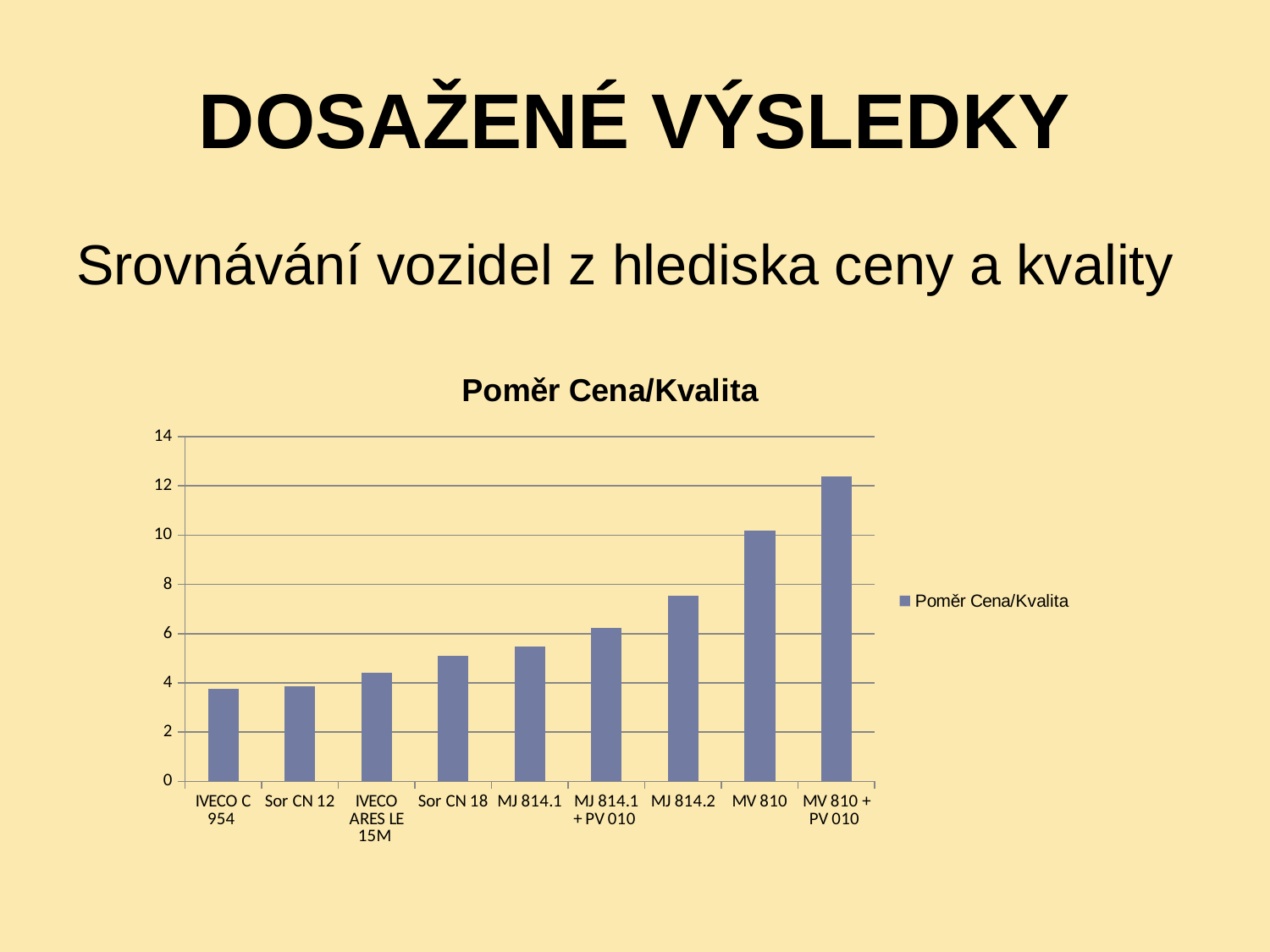
What kind of chart is shown on the slide? bar chart Is the value for MJ 814.2 greater or less than 8? less Which has a larger value, MV 810 or MJ 814.2? MV 810 What is the title of the chart? Poměr Cena/Kvalita How many vehicle categories are plotted on the x axis? 9 Which vehicle has the highest Poměr Cena/Kvalita value? MV 810 + PV 010 Do the values rise or fall from left to right along the x axis? rise How many series does the legend list? 1 Is the value for Sor CN 18 greater or less than 4? greater Is the value for MV 810 + PV 010 greater or less than 12? greater